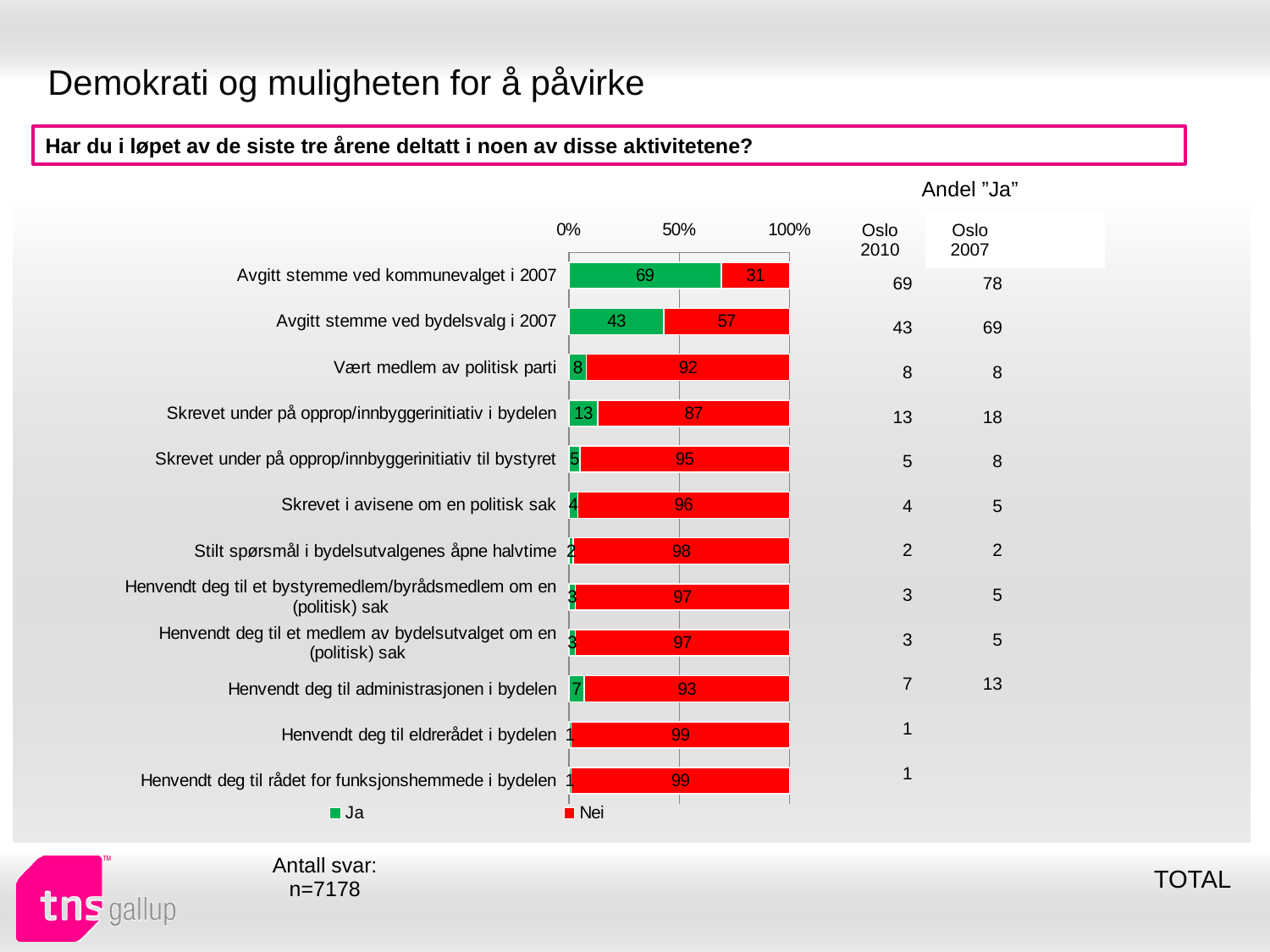
Which colour represents the "Nei" series in the chart? Red Which has a larger "Ja" value: "Skrevet under på opprop/innbyggerinitiativ i bydelen" or "Henvendt deg til administrasjonen i bydelen"? Skrevet under på opprop/innbyggerinitiativ i bydelen What is the "Nei" value for "Vært medlem av politisk parti"? 92 What is the "Ja" value for "Avgitt stemme ved kommunevalget i 2007"? 69 What is the difference between the "Ja" values for "Avgitt stemme ved kommunevalget i 2007" and "Avgitt stemme ved bydelsvalg i 2007"? 26 What is the "Nei" value for "Avgitt stemme ved bydelsvalg i 2007"? 57 Is the "Nei" value for "Avgitt stemme ved kommunevalget i 2007" greater or less than 50%? less How many series does the chart legend list? 2 What kind of chart is shown on the slide? Stacked bar chart Which category has the highest "Ja" value? Avgitt stemme ved kommunevalget i 2007 What is the total of the stacked bar for "Skrevet under på opprop/innbyggerinitiativ i bydelen"? 100 How many activity categories are plotted in the chart? 12